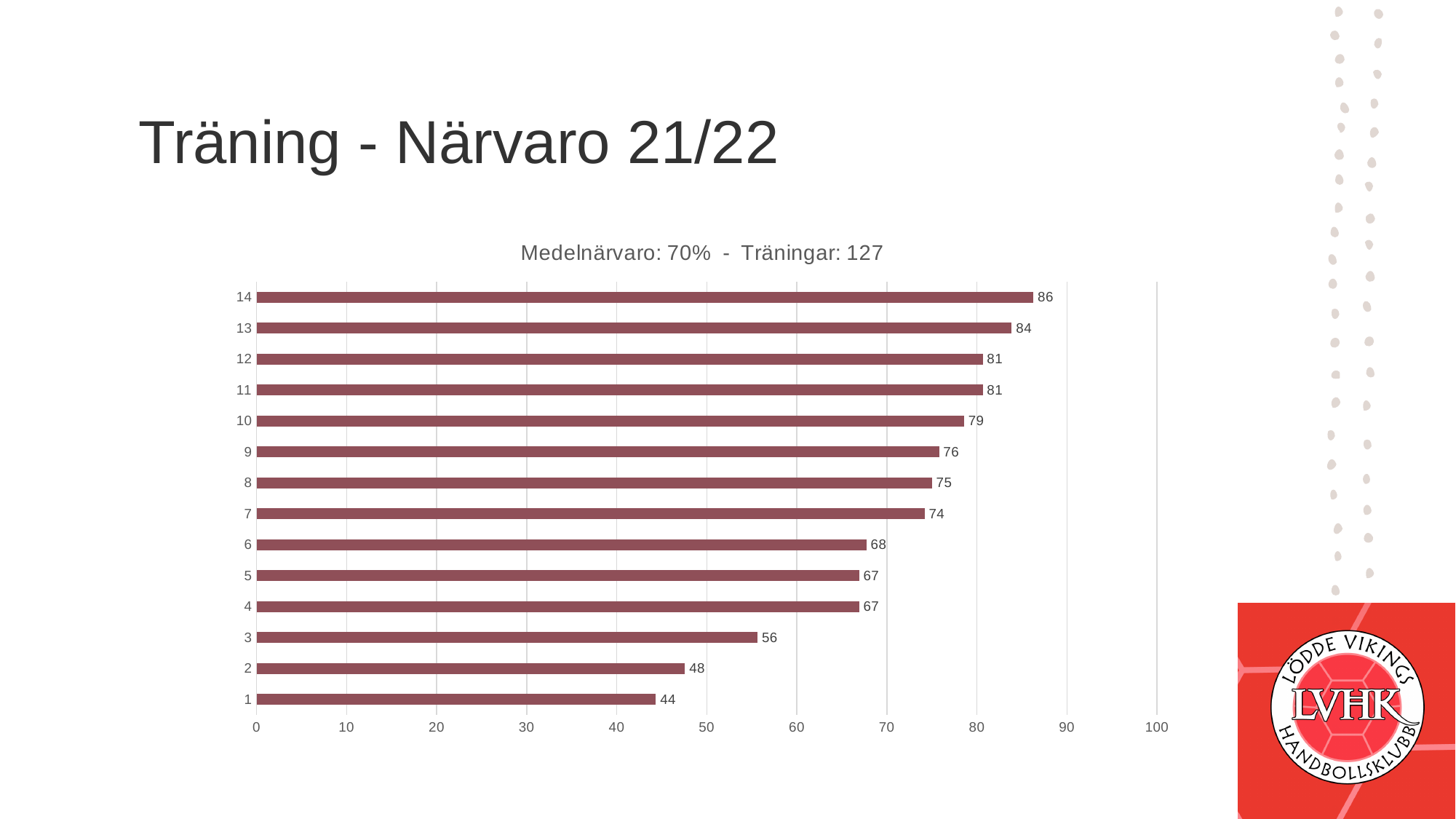
What is the title of the chart? Medelnärvaro: 70% - Träningar: 127 Which category has the lowest value? 1 What is the value for category 14? 86 Is the value for category 7 greater or less than 70? greater Which has a larger value, category 2 or category 6? 6 What is the difference between the values for category 13 and category 9? 8 What is the difference between the values for category 14 and category 1? 42 How many categories are shown in the chart? 14 What kind of chart is shown on the slide? bar chart What is the value for category 3? 56 What is the value for category 10? 79 Which category has the highest value? 14